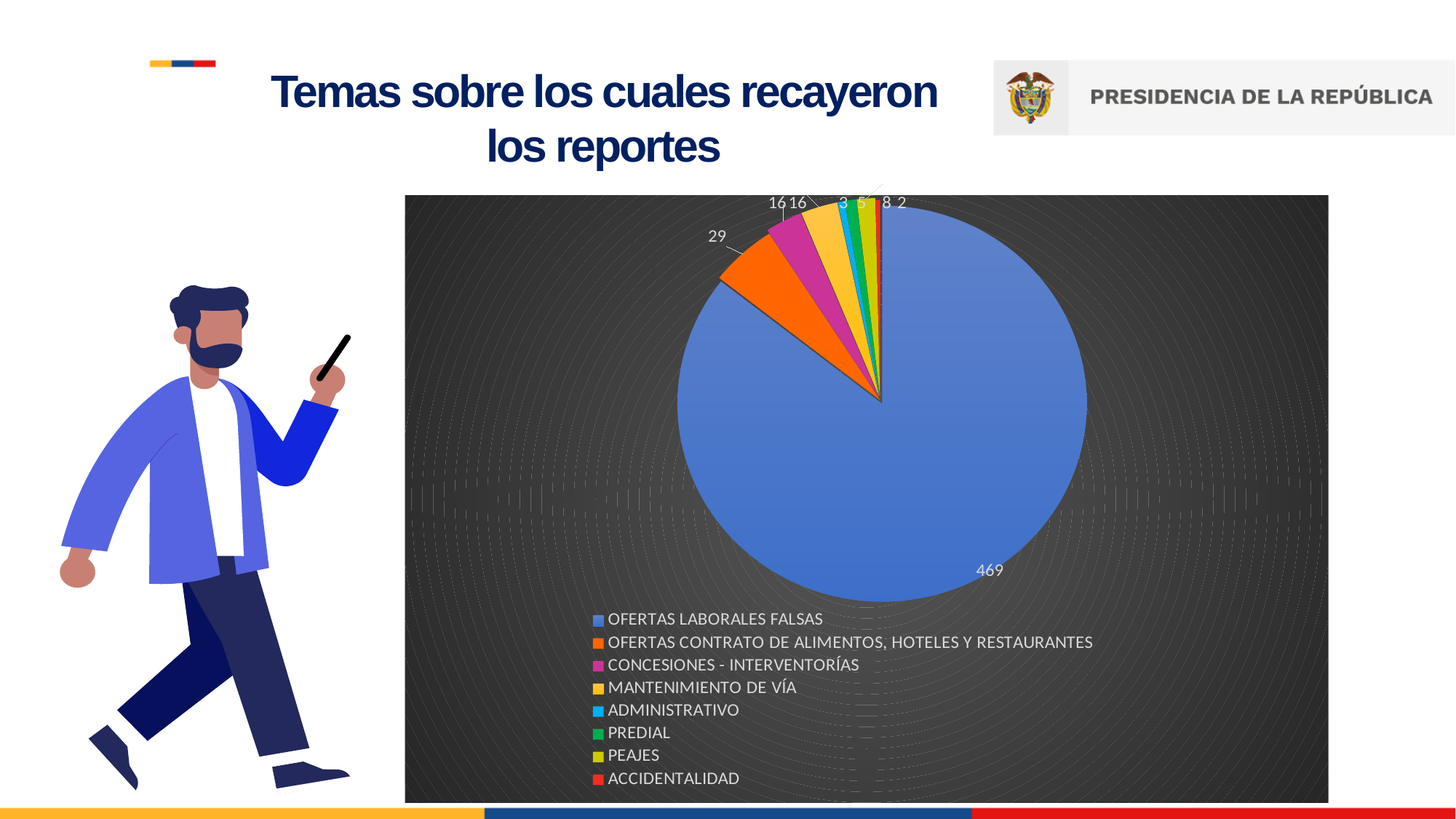
What is the total of all the values shown in the pie chart? 548 How many categories does the pie chart's legend list? 8 What is the value for OFERTAS LABORALES FALSAS? 469 Which category has the largest slice of the pie? OFERTAS LABORALES FALSAS What kind of chart is shown on the slide? Pie chart Which category has the smallest slice of the pie? ACCIDENTALIDAD What is the difference between the values for OFERTAS LABORALES FALSAS and OFERTAS CONTRATO DE ALIMENTOS, HOTELES Y RESTAURANTES? 440 What is the value for ADMINISTRATIVO? 3 What colour is the slice for CONCESIONES - INTERVENTORÍAS? Magenta (pink-purple) What is the value for OFERTAS CONTRATO DE ALIMENTOS, HOTELES Y RESTAURANTES? 29 Which is larger, the value for PREDIAL or the value for ADMINISTRATIVO? PREDIAL What is the value for PEAJES? 8